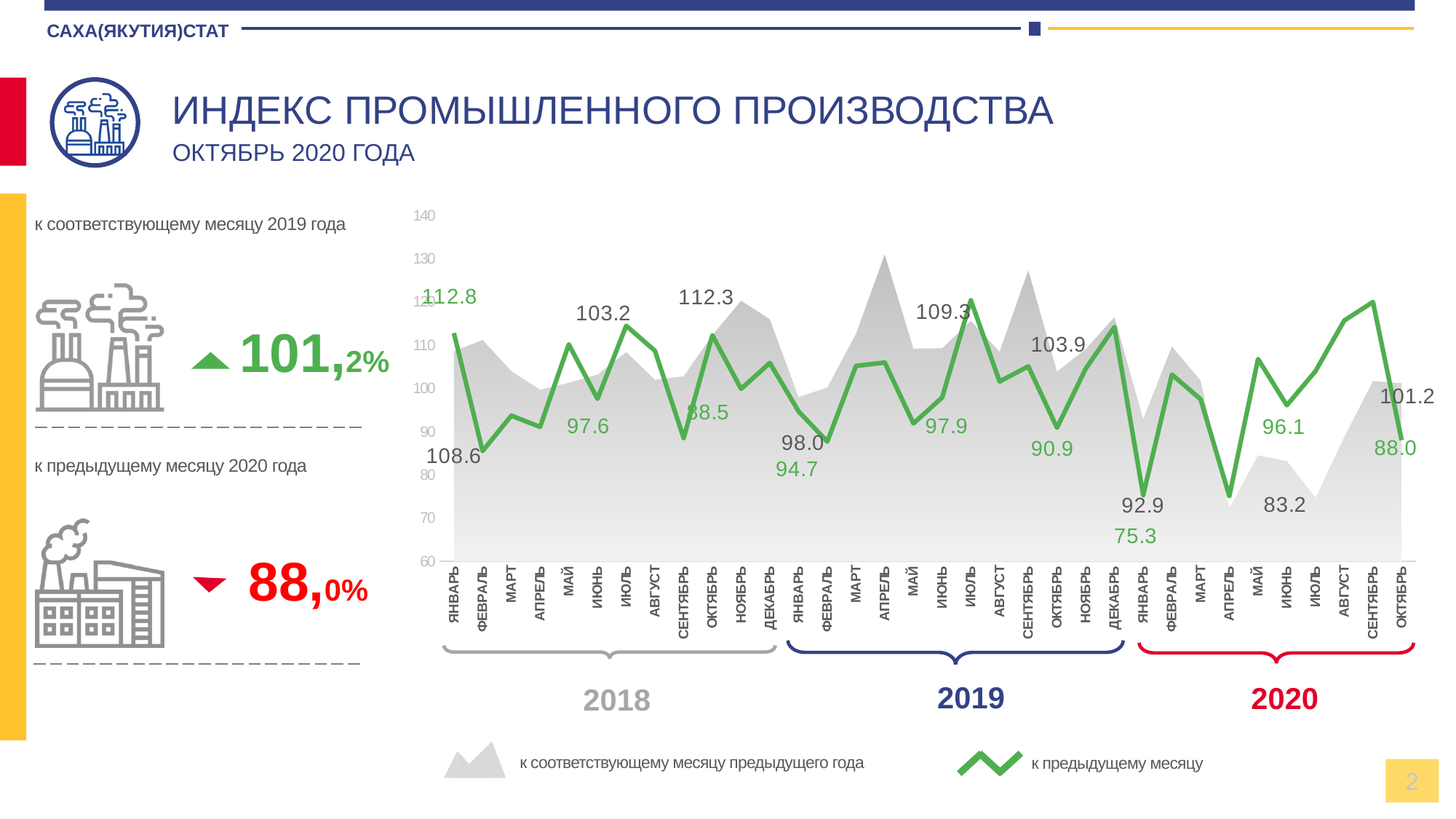
Is the grey area value for April 2019 greater or less than 120? greater For October 2020, which is larger: the grey area value or the green line value? The grey area value (101.2) What is the value of the green line (к предыдущему месяцу) for October 2020? 88.0 Which three years are marked with brackets under the x axis? 2018, 2019, 2020 Is the green line value for April 2020 greater or less than 80? less Does the green line rise or fall from September 2020 to October 2020? It falls What is the value of the grey area (к соответствующему месяцу предыдущего года) for January 2020? 92.9 What is the difference between the grey area value and the green line value for October 2020? 13.2 What is the value of the grey area (к соответствующему месяцу предыдущего года) for October 2020? 101.2 How many series does the chart legend list? 2 What is the value of the green line (к предыдущему месяцу) for January 2020? 75.3 What kind of chart is shown on the slide? A combined area and line chart